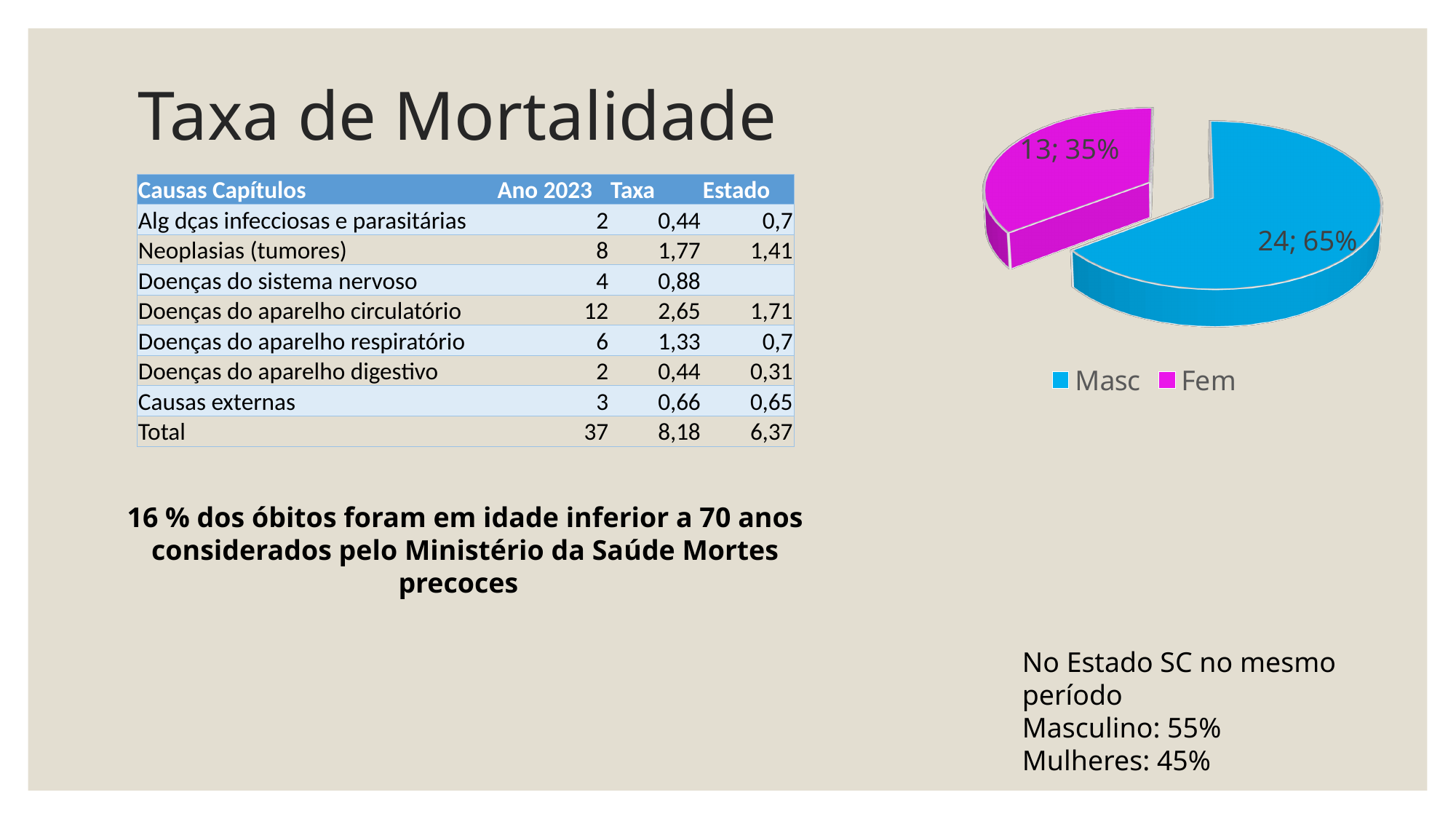
Which slice of the pie chart is the smallest? Fem What share of the pie does the Masc slice represent? 65% What kind of chart is shown on the slide? Pie chart What is the value shown for the Fem slice of the pie chart? 13 How many slices does the pie chart have? 2 Which slice of the pie chart is the largest? Masc What is the difference between the Masc and Fem values in the pie chart? 11 What colour is the Fem slice in the pie chart? Magenta Which is larger in the pie chart, Masc or Fem? Masc What is the value shown for the Masc slice of the pie chart? 24 What share of the pie does the Fem slice represent? 35% How many entries does the pie chart's legend list? 2